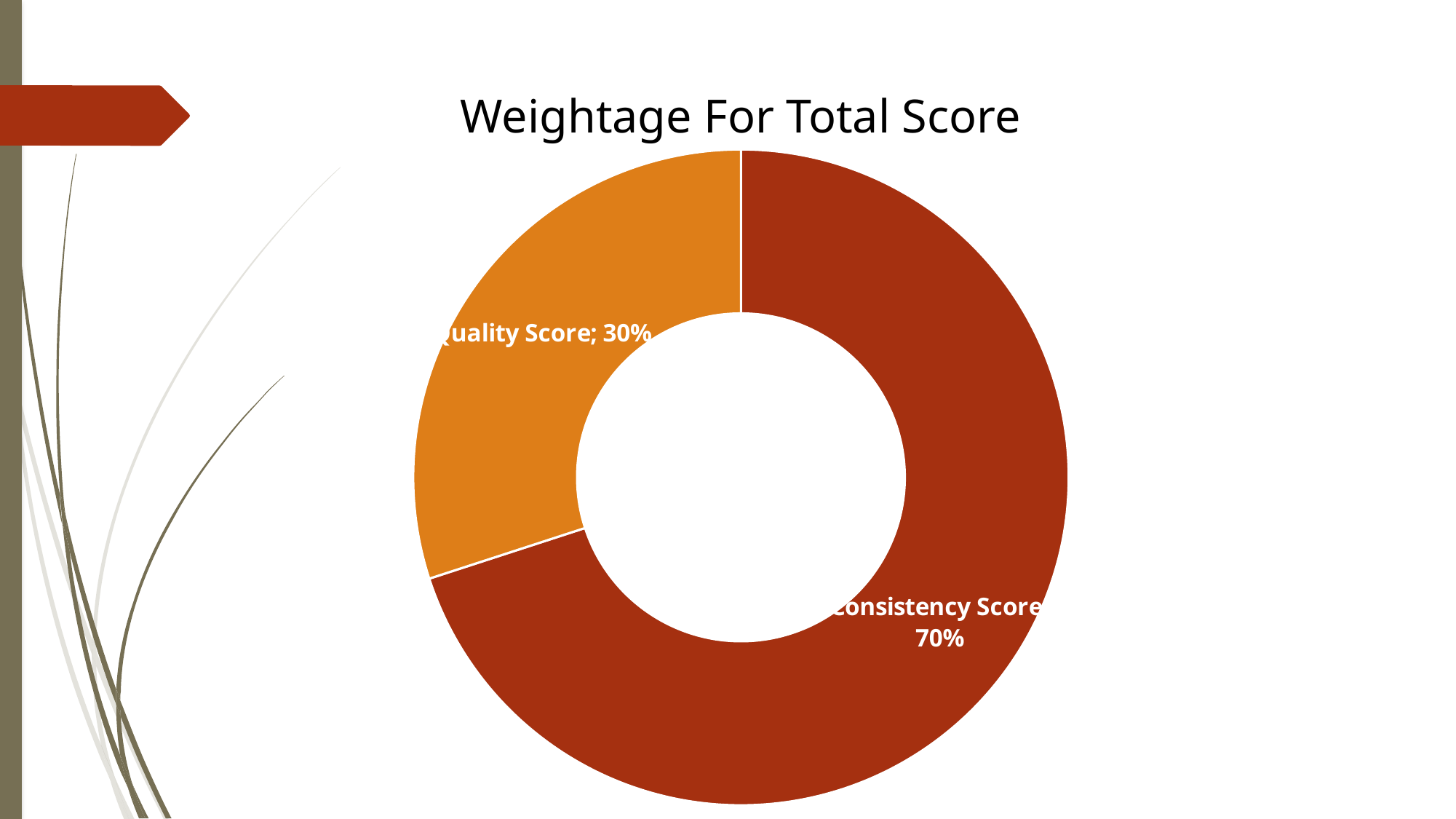
What is the title of the chart? Weightage For Total Score Which category has the smallest share of the chart? Quality Score What is the weightage for Quality Score? 30% What is the difference between the Consistency Score and Quality Score weightages? 40% What colour is the Consistency Score slice? Dark red Which category has the largest share of the chart? Consistency Score What kind of chart is shown on the slide? Doughnut chart What is the weightage for Consistency Score? 70% How many categories are shown in the chart? 2 What share of the chart does the Quality Score slice represent? 30% Which is larger, the weightage for Quality Score or for Consistency Score? Consistency Score